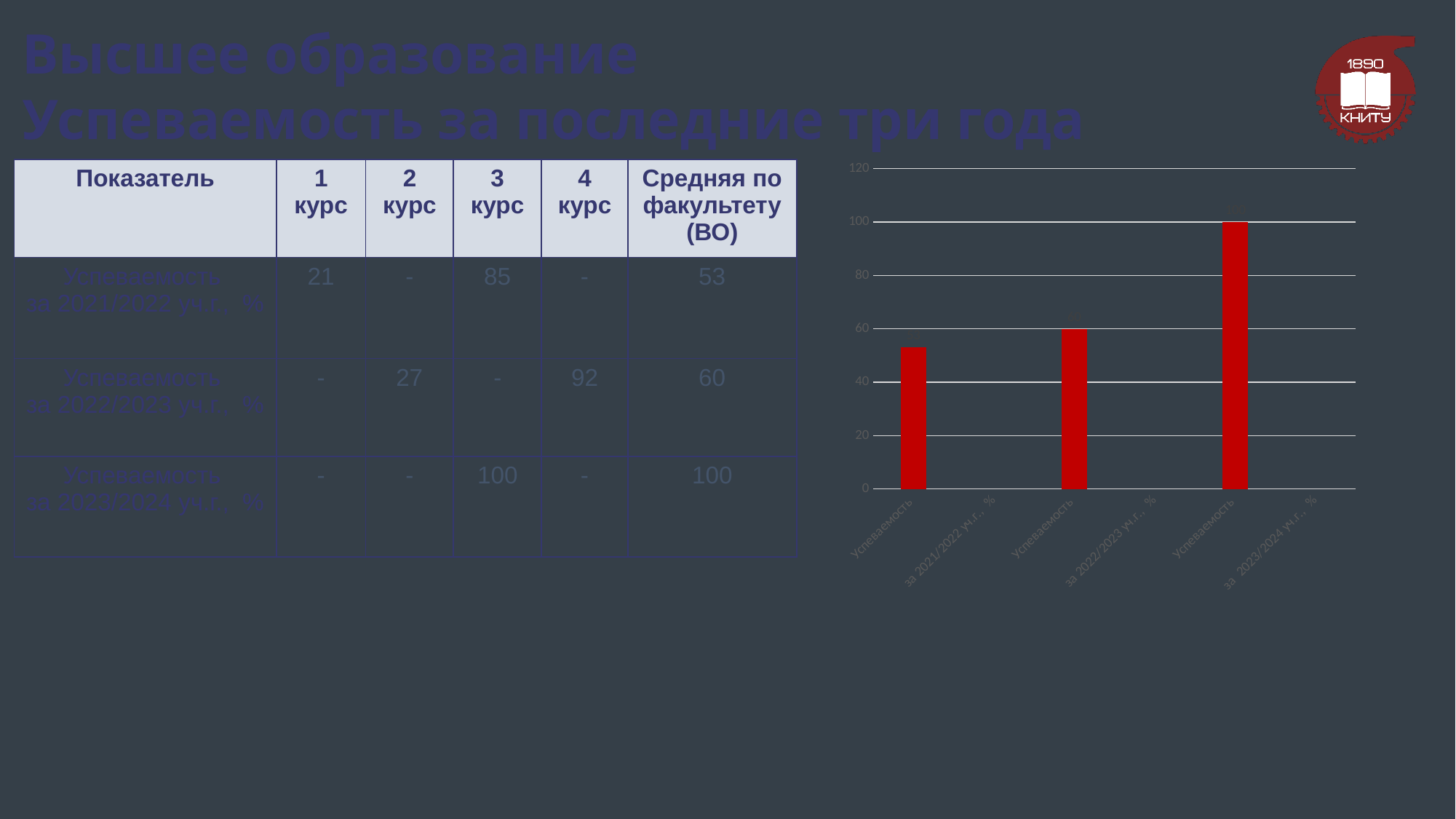
Is the value for Успеваемость за 2021/2022 уч.г., % greater or less than 60? less What colour are the bars in the chart? red How many bars does the chart show? 3 Do the bar values rise or fall from left to right along the x axis? rise What value does the bar for Успеваемость за 2023/2024 уч.г., % reach on the axis? 100 Is the value for Успеваемость за 2021/2022 уч.г., % greater or less than 40? greater Which category has the highest bar in the chart? Успеваемость за 2023/2024 уч.г., % What is the difference between the bar for Успеваемость за 2023/2024 уч.г., % and the bar for Успеваемость за 2022/2023 уч.г., %? 40 Which category has the lowest bar in the chart? Успеваемость за 2021/2022 уч.г., % What kind of chart is shown on the right side of the slide? bar chart What value does the bar for Успеваемость за 2022/2023 уч.г., % reach on the axis? 60 Which is larger: the bar for Успеваемость за 2022/2023 уч.г., % or the bar for Успеваемость за 2023/2024 уч.г., %? Успеваемость за 2023/2024 уч.г., %